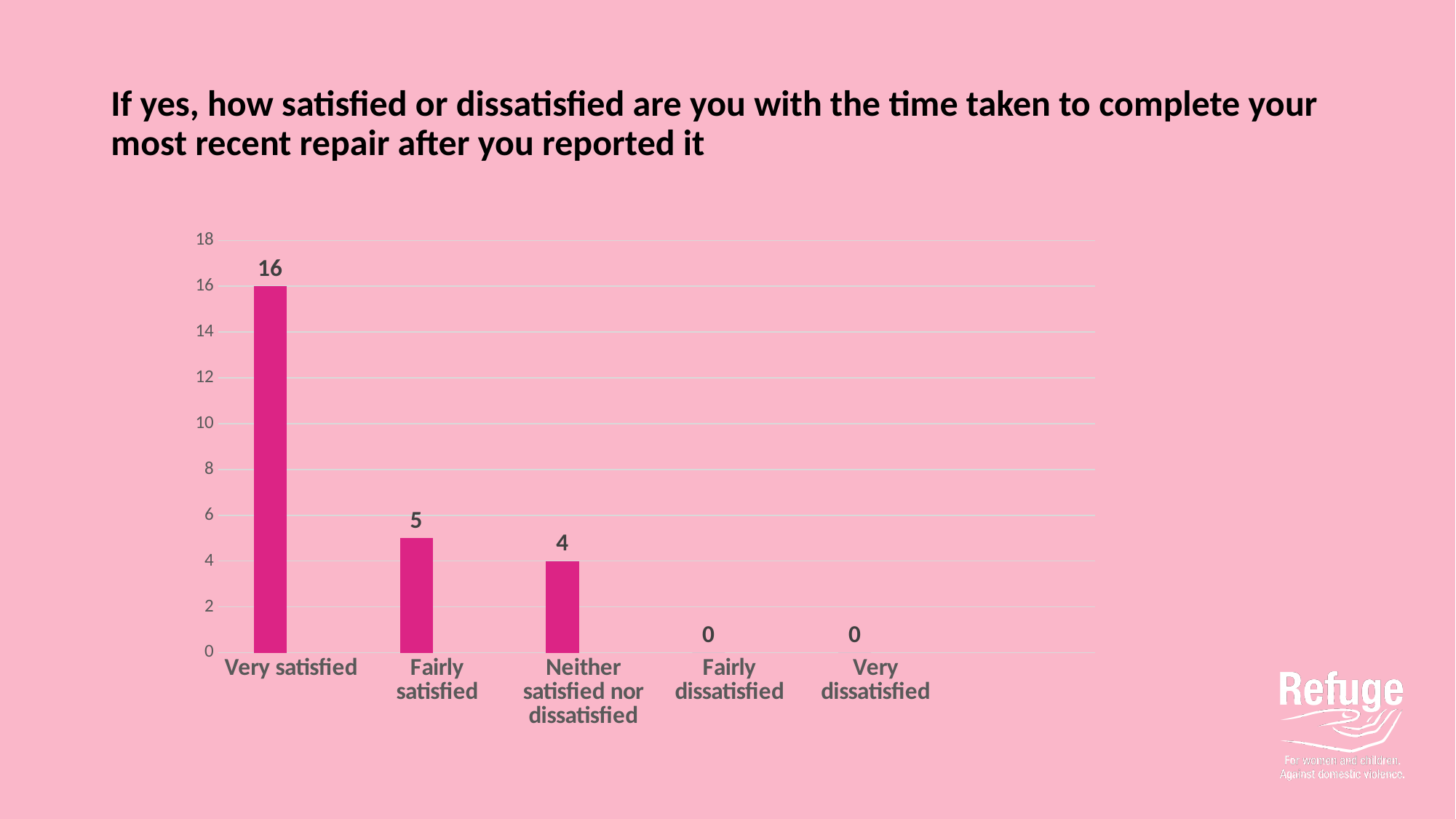
Which is larger, the value for Fairly satisfied or the value for Neither satisfied nor dissatisfied? Fairly satisfied What is the value for Neither satisfied nor dissatisfied? 4 Do the values rise or fall from left to right along the x axis? fall What is the value for Very satisfied? 16 What is the difference between the values for Fairly satisfied and Neither satisfied nor dissatisfied? 1 What is the value for Fairly satisfied? 5 Which category has the highest value? Very satisfied How many categories are shown on the x axis? 5 What is the value for Fairly dissatisfied? 0 What kind of chart is shown on the slide? bar chart Is the value for Very satisfied greater or less than 10? greater What is the difference between the values for Very satisfied and Fairly satisfied? 11